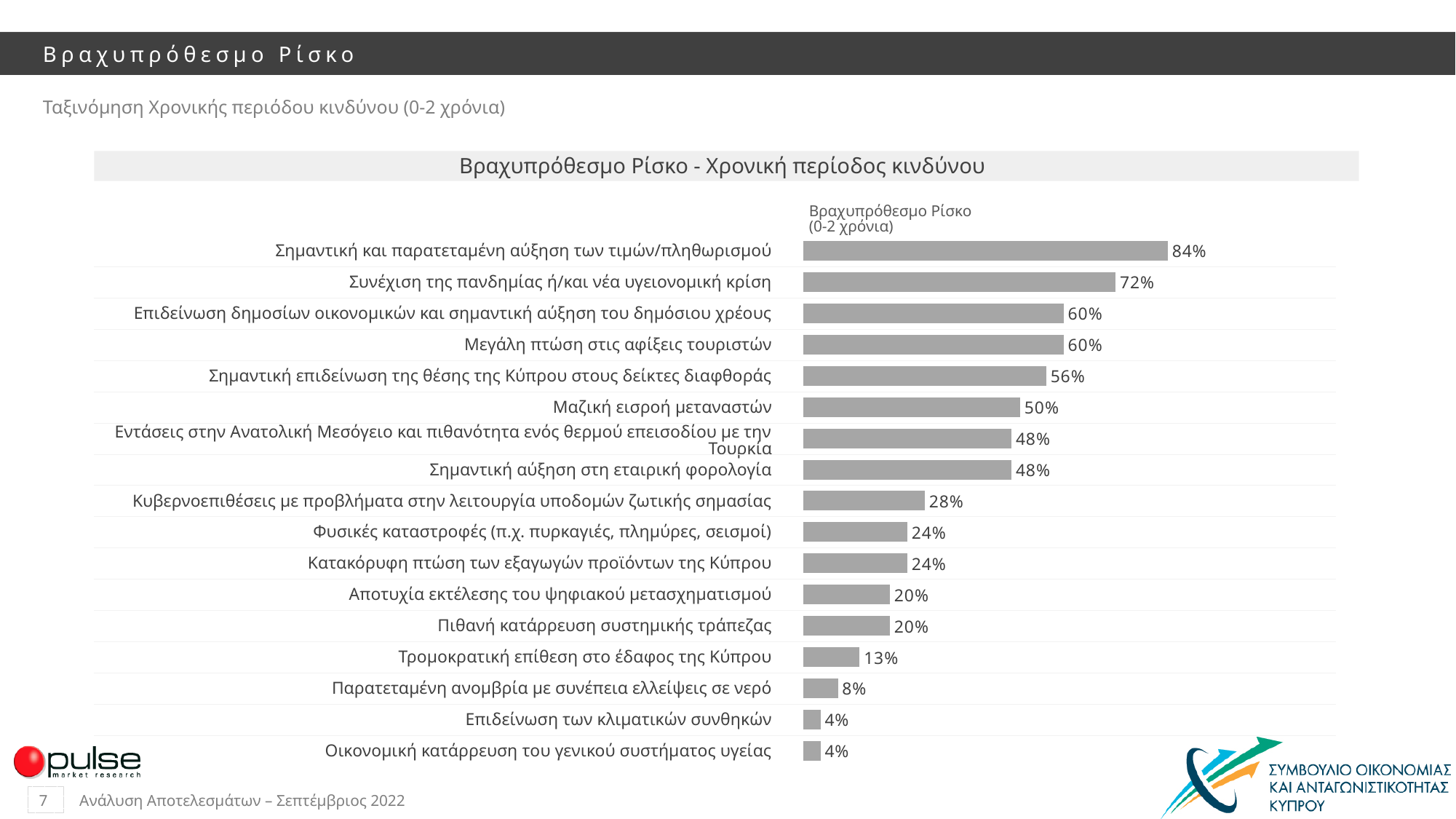
What is the value for 'Τρομοκρατική επίθεση στο έδαφος της Κύπρου'? 13% What is the name of the data series shown above the bars? Βραχυπρόθεσμο Ρίσκο (0-2 χρόνια) What is the title of the chart? Βραχυπρόθεσμο Ρίσκο - Χρονική περίοδος κινδύνου What is the value for 'Κυβερνοεπιθέσεις με προβλήματα στην λειτουργία υποδομών ζωτικής σημασίας'? 28% What is the value for 'Σημαντική και παρατεταμένη αύξηση των τιμών/πληθωρισμού'? 84% What is the lowest value shown in the chart? 4% How many categories are shown in the chart? 17 What is the value for 'Μαζική εισροή μεταναστών'? 50% What is the difference between the values for 'Συνέχιση της πανδημίας ή/και νέα υγειονομική κρίση' and 'Μεγάλη πτώση στις αφίξεις τουριστών'? 12% What type of chart is shown on the slide? Bar chart Which is larger: the value for 'Φυσικές καταστροφές (π.χ. πυρκαγιές, πλημύρες, σεισμοί)' or the value for 'Παρατεταμένη ανομβρία με συνέπεια ελλείψεις σε νερό'? Φυσικές καταστροφές (π.χ. πυρκαγιές, πλημύρες, σεισμοί) Which category has the highest value? Σημαντική και παρατεταμένη αύξηση των τιμών/πληθωρισμού